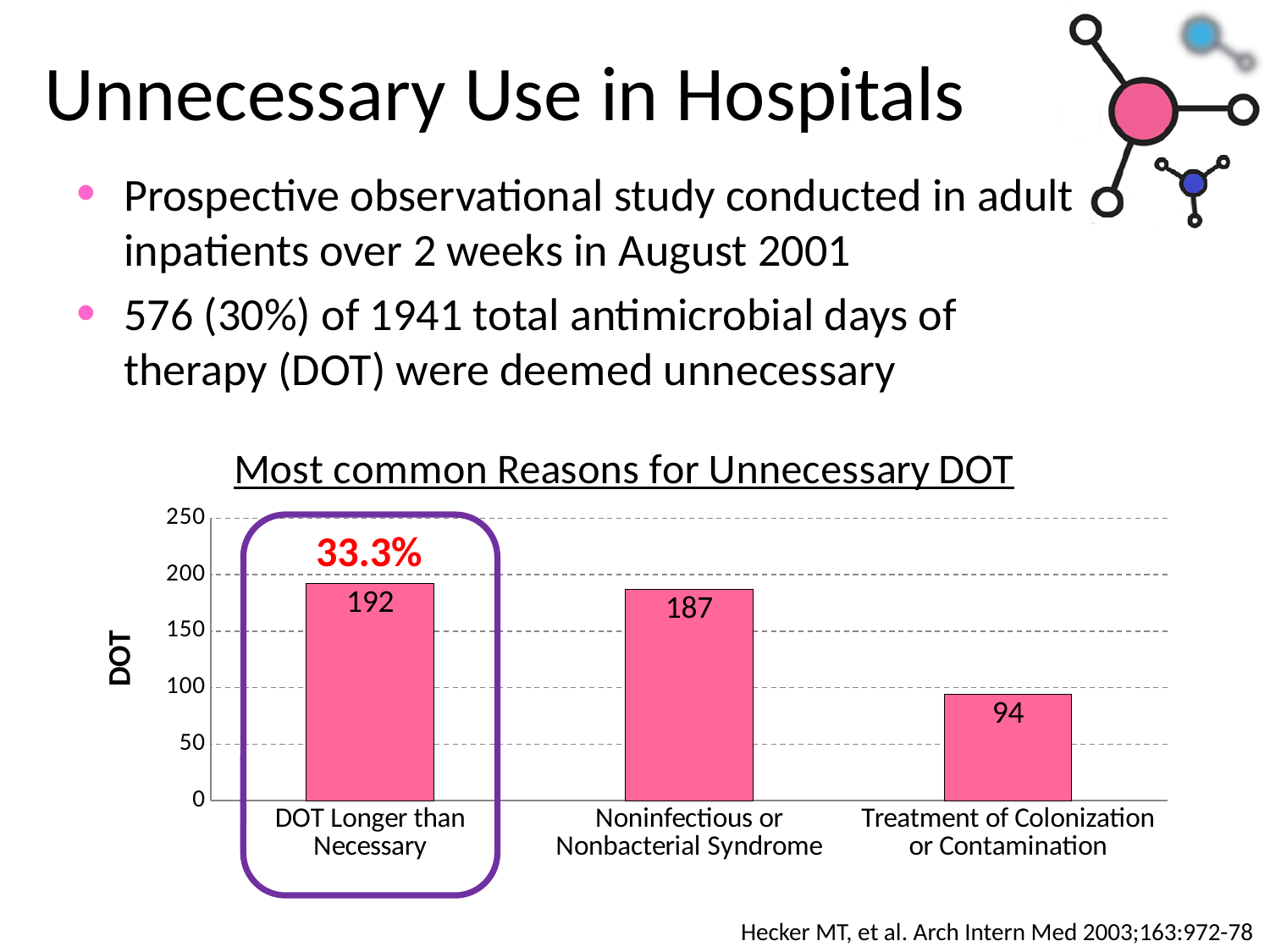
Is the DOT value for "Treatment of Colonization or Contamination" greater or less than 100? less How many categories are shown in the chart? 3 What is the DOT value for "Treatment of Colonization or Contamination"? 94 What is the title of the chart? Most common Reasons for Unnecessary DOT What is the difference in DOT between "DOT Longer than Necessary" and "Treatment of Colonization or Contamination"? 98 What is the DOT value for "DOT Longer than Necessary"? 192 What is the DOT value for "Noninfectious or Nonbacterial Syndrome"? 187 What type of chart is shown on the slide? bar chart What is the difference in DOT between "DOT Longer than Necessary" and "Noninfectious or Nonbacterial Syndrome"? 5 Which category has the highest DOT value? DOT Longer than Necessary Which has a larger DOT value: "Noninfectious or Nonbacterial Syndrome" or "Treatment of Colonization or Contamination"? Noninfectious or Nonbacterial Syndrome Which category has the lowest DOT value? Treatment of Colonization or Contamination